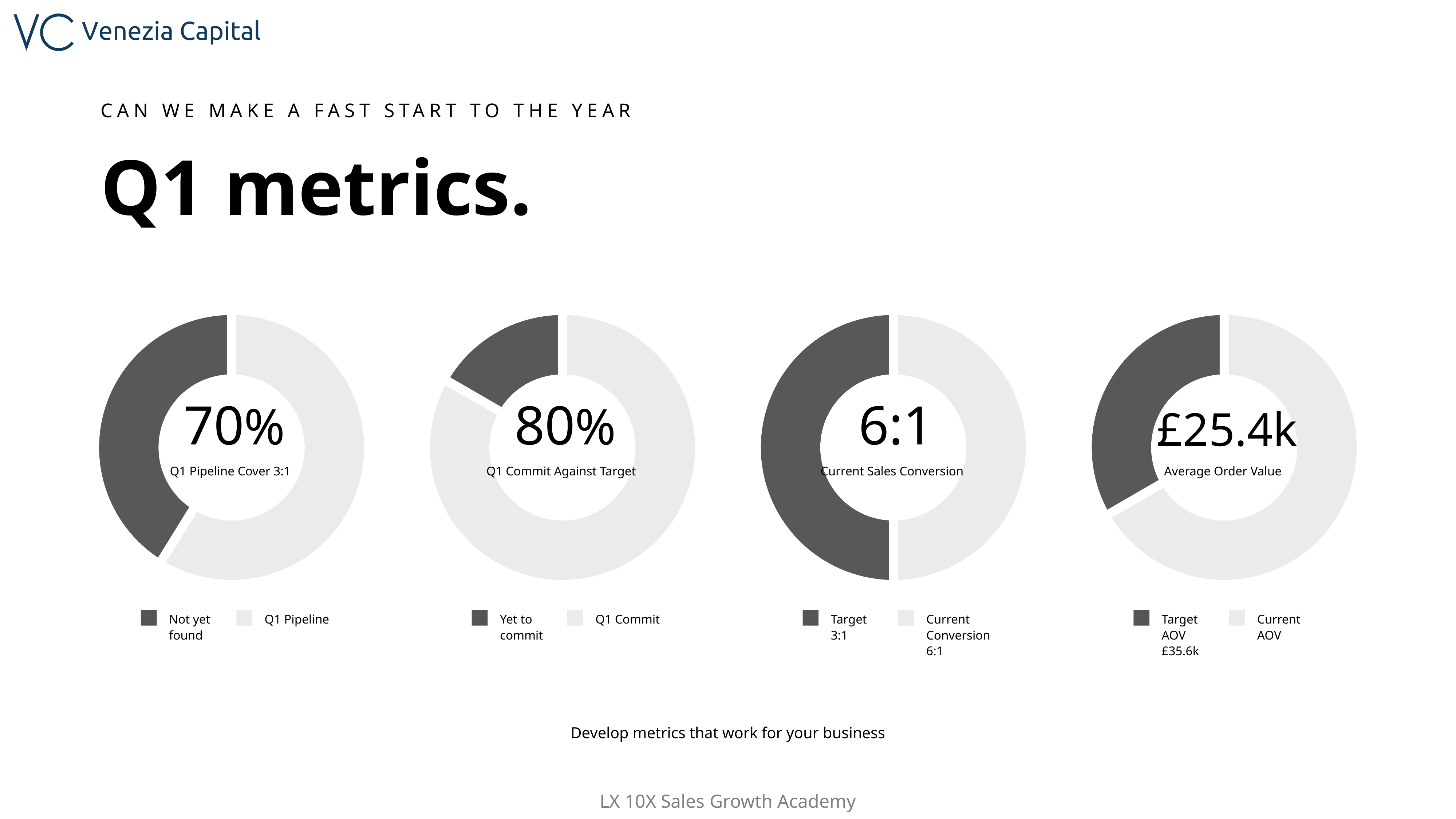
What are the two legend entries of the leftmost chart (Q1 Pipeline Cover 3:1)? Not yet found; Q1 Pipeline What value is shown in the centre of the leftmost donut chart, labelled Q1 Pipeline Cover 3:1? 70% In the Current Sales Conversion chart, what target ratio is given in the legend? 3:1 In the leftmost chart (Q1 Pipeline Cover 3:1), which slice is larger: Not yet found or Q1 Pipeline? Q1 Pipeline How many donut charts are shown on the slide? 4 How many entries does the legend of the Q1 Commit Against Target chart list? 2 What value is shown in the centre of the Current Sales Conversion chart? 6:1 What kind of chart is used for the Q1 Pipeline Cover 3:1 metric? Donut chart In the Q1 Commit Against Target chart, which slice is larger: Yet to commit or Q1 Commit? Q1 Commit In the Average Order Value chart, what Target AOV figure is given in the legend? £35.6k What value is shown in the centre of the Q1 Commit Against Target chart? 80% What value is shown in the centre of the Average Order Value chart? £25.4k